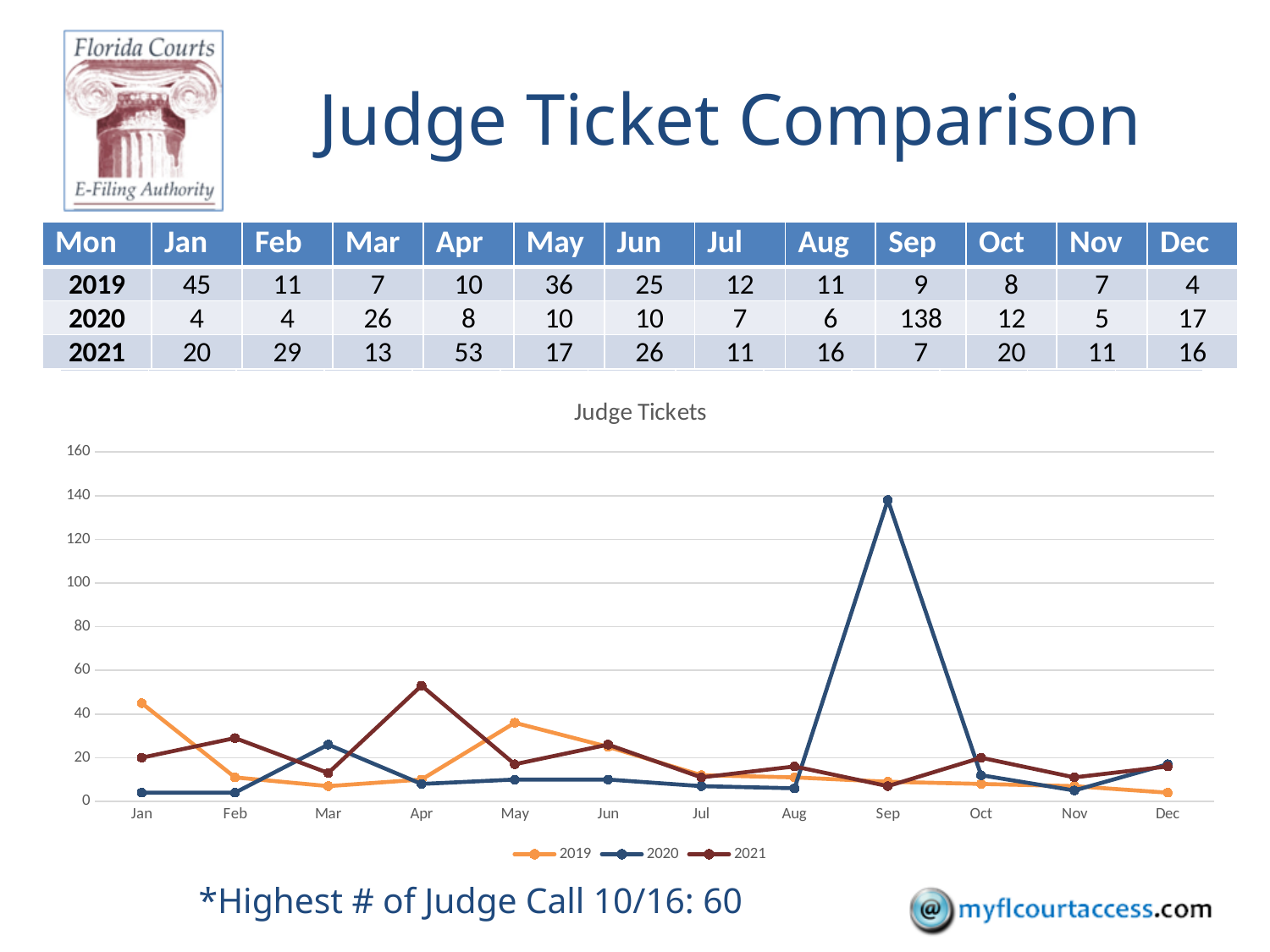
What is the value for 2019 in Jan? 45 What is the title of the chart? Judge Tickets In which month does the 2019 series have its lowest value? Dec In which month does the 2020 series reach its highest value? Sep What is the difference between the 2020 value in Sep and the 2021 value in Sep? 131 What is the value for 2021 in Apr? 53 How many months are plotted along the x axis? 12 Which is larger in May, the 2019 value or the 2021 value? 2019 How many series does the chart legend list? 3 What type of chart is shown on the slide? line chart Is the value for 2020 in Sep greater or less than 120? greater What is the value for 2020 in Sep? 138